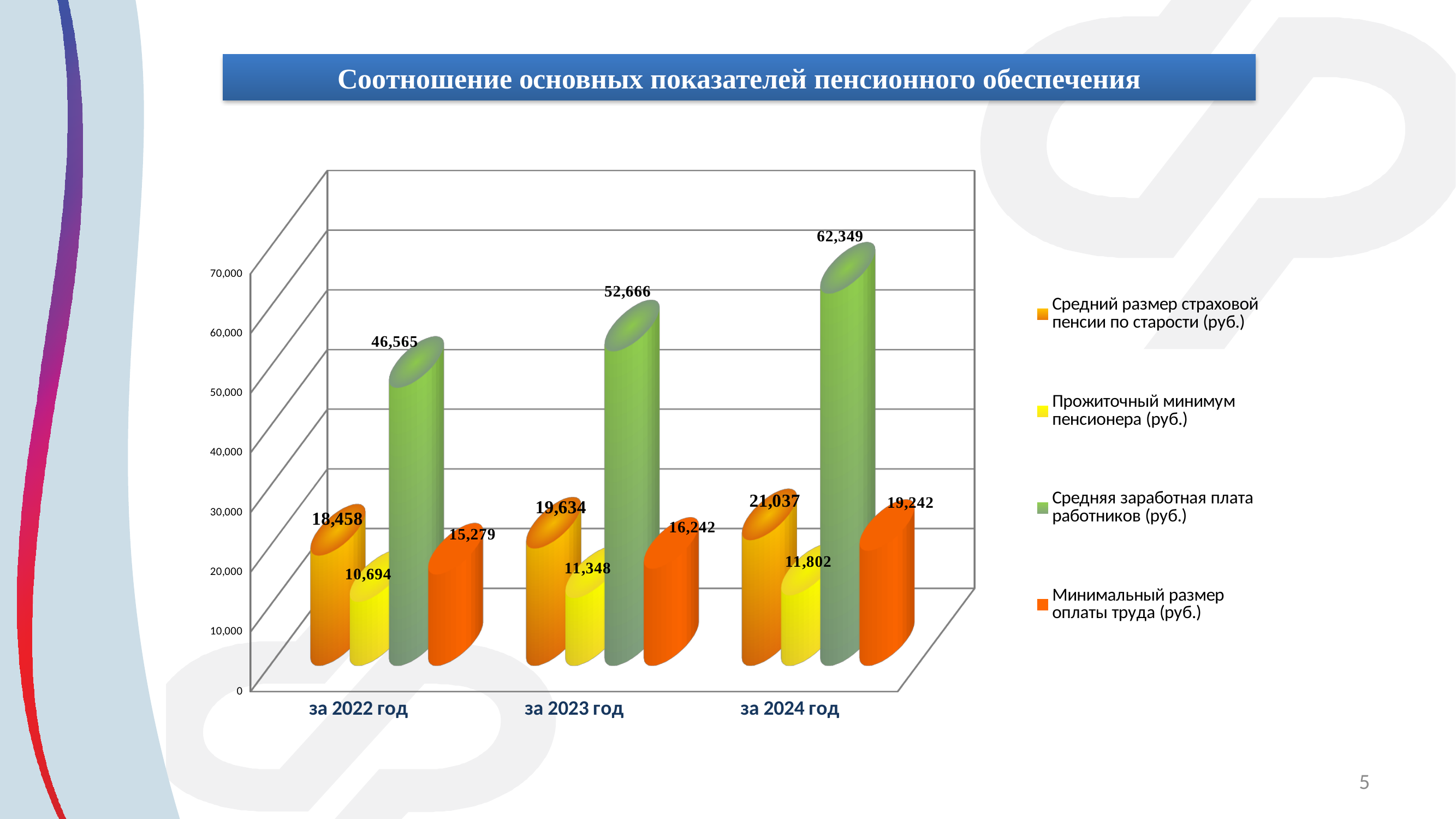
What is the value of Средняя заработная плата работников (руб.) for за 2024 год? 62,349 What kind of chart is shown on the slide? bar chart What is the value of Прожиточный минимум пенсионера (руб.) for за 2022 год? 10,694 What is the difference between Средняя заработная плата работников (руб.) for за 2024 год and за 2023 год? 9,683 In which year is Прожиточный минимум пенсионера (руб.) the lowest? за 2022 год In which year is Средняя заработная плата работников (руб.) the highest? за 2024 год How many year categories are shown on the x axis? 3 What is the value of Средний размер страховой пенсии по старости (руб.) for за 2024 год? 21,037 How many series does the legend list? 4 Which is larger for за 2022 год: Средний размер страховой пенсии по старости (руб.) or Минимальный размер оплаты труда (руб.)? Средний размер страховой пенсии по старости (руб.) What is the value of Минимальный размер оплаты труда (руб.) for за 2023 год? 16,242 Does Минимальный размер оплаты труда (руб.) rise or fall from за 2022 год to за 2024 год? rise